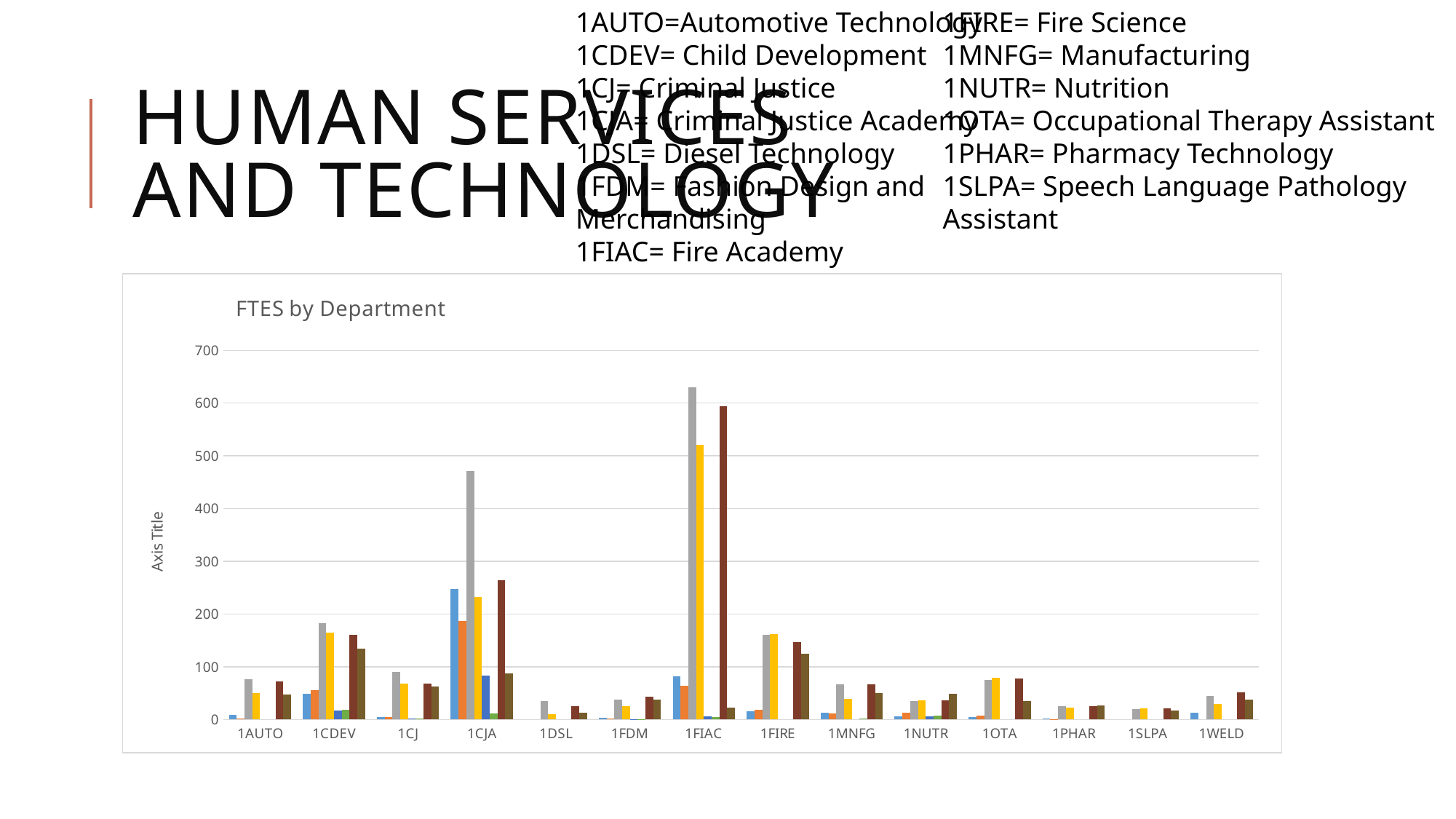
Is the tallest (gray) bar for 1FIAC greater or less than 600? greater Which department has the tallest bar in the chart? 1FIAC Which has the taller gray bar, 1FIAC or 1CJA? 1FIAC Is the tallest (gray) bar for 1CJA greater or less than 500? less What is the title of the chart on the slide? FTES by Department Which has the taller gray bar, 1CJA or 1CDEV? 1CJA Is the tallest (gray) bar for 1CDEV greater or less than 200? less What kind of chart is shown on the slide? bar chart What is the label shown on the vertical axis of the chart? Axis Title How many departments (categories) are shown on the x axis of the chart? 14